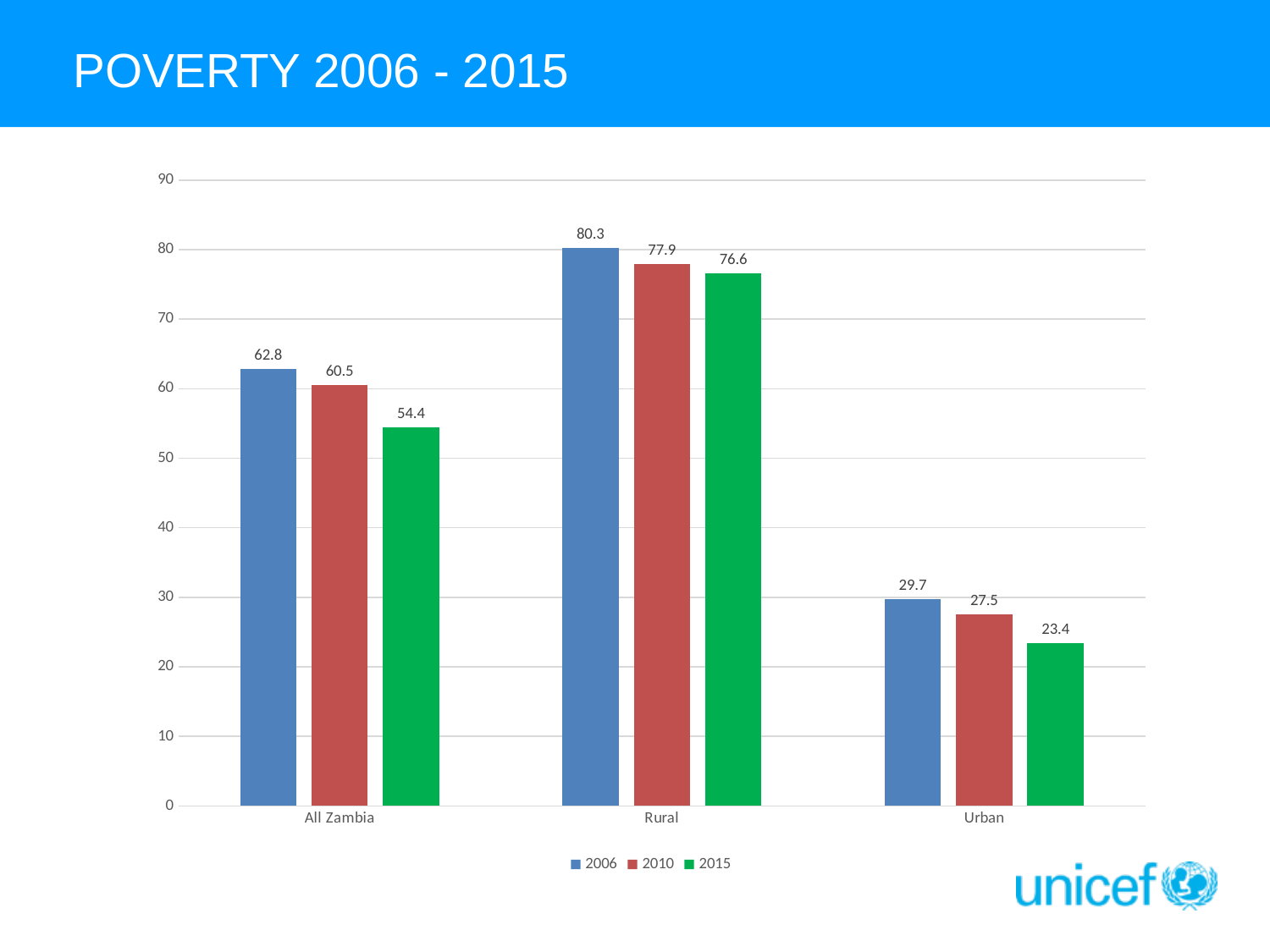
What is the value for All Zambia in 2010? 60.5 Which category has the highest value in 2015? Rural Which category has the lowest value in 2006? Urban Do the values for Rural rise or fall from 2006 to 2015? fall How many categories are shown on the x axis? 3 What is the difference between the 2006 and 2015 values for All Zambia? 8.4 What kind of chart is shown on the slide? bar chart Is the value for Urban in 2006 greater or less than 30? less Which is larger, the 2010 value for Rural or the 2010 value for Urban? Rural What is the value for Urban in 2015? 23.4 What is the value for Rural in 2006? 80.3 How many series does the legend list? 3